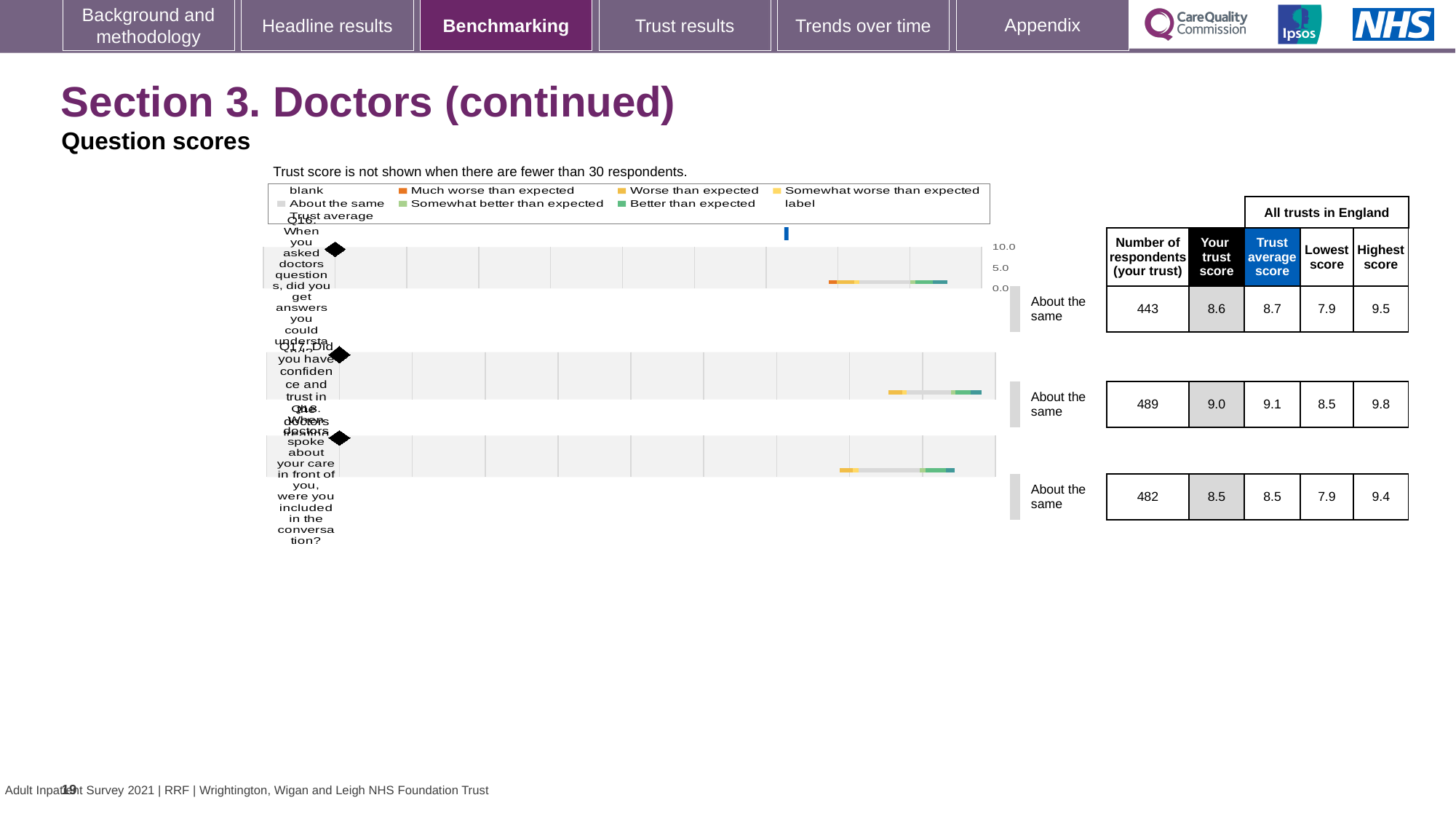
For Q16, which is larger: your trust score or the trust average score? Trust average score What benchmarking category is shown for all three questions? About the same For Q16, what is the difference between the trust average score and your trust score? 0.1 What kind of chart is shown on the slide? Bar chart What is the 'Your trust score' for Q17 (confidence and trust in the doctors treating you)? 9.0 What is the trust average score for Q18 (were you included in the conversation)? 8.5 Which question has the highest 'Your trust score'? Q17 Which question has the lowest 'Your trust score'? Q18 What is the difference between the highest score and the lowest score for Q17? 1.3 How many respondents from your trust answered Q16 (did you get answers you could understand)? 443 What is the highest score across all trusts in England for Q17? 9.8 How many questions are plotted on the chart? 3